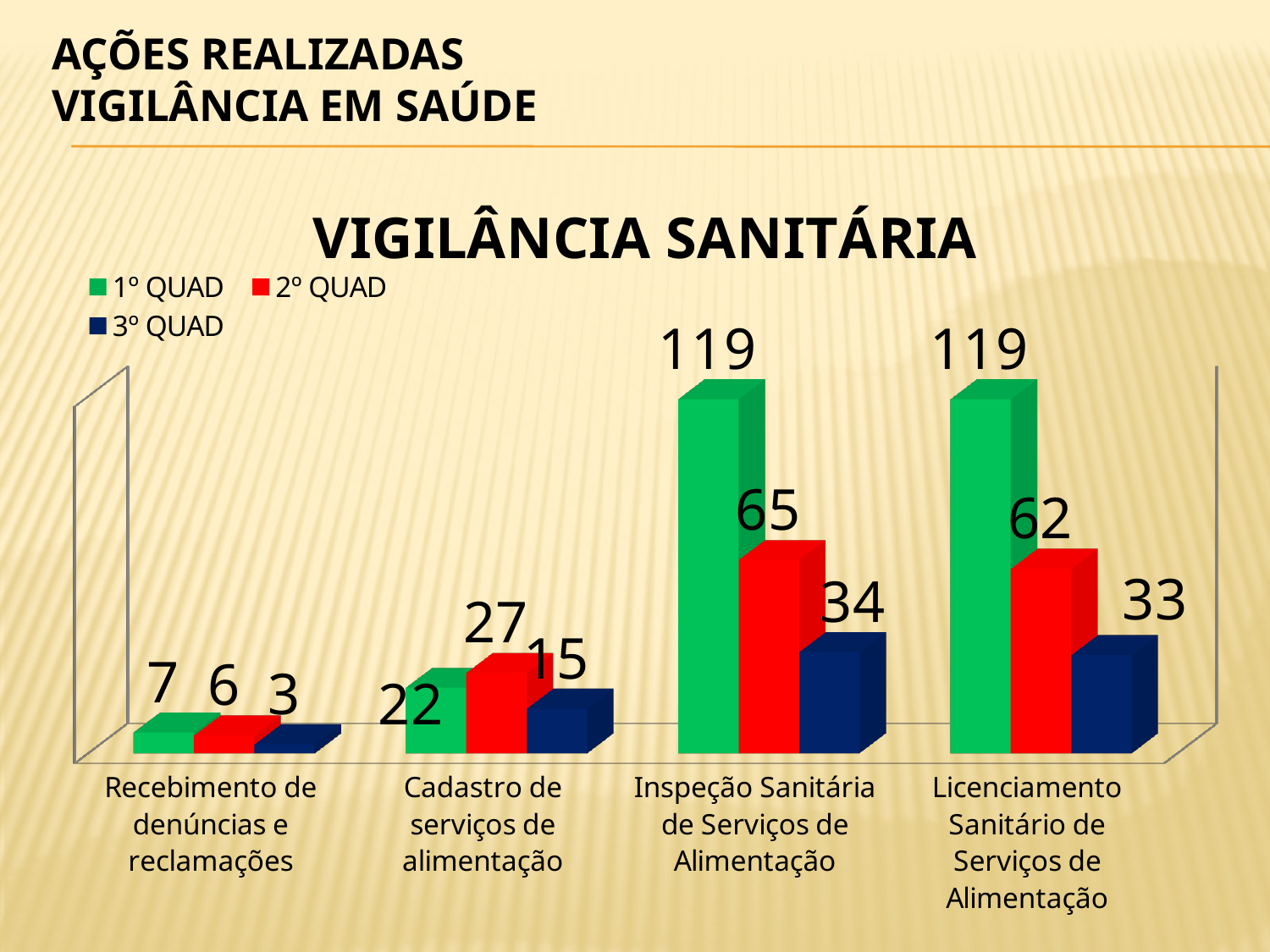
What is the value for 1º QUAD in the 'Inspeção Sanitária de Serviços de Alimentação' category? 119 What is the title of the chart? VIGILÂNCIA SANITÁRIA What kind of chart is shown on the slide? Bar chart What is the value for 3º QUAD in the 'Recebimento de denúncias e reclamações' category? 3 What is the value for 2º QUAD in the 'Licenciamento Sanitário de Serviços de Alimentação' category? 62 What is the difference between the 1º QUAD and 2º QUAD values for 'Inspeção Sanitária de Serviços de Alimentação'? 54 Which is larger: the 3º QUAD value for 'Inspeção Sanitária de Serviços de Alimentação' or the 3º QUAD value for 'Licenciamento Sanitário de Serviços de Alimentação'? Inspeção Sanitária de Serviços de Alimentação Which series has the highest value in the 'Cadastro de serviços de alimentação' category? 2º QUAD Which category has the lowest value for 1º QUAD? Recebimento de denúncias e reclamações What is the value for 2º QUAD in the 'Cadastro de serviços de alimentação' category? 27 How many categories are shown on the x axis? 4 How many series does the legend list? 3